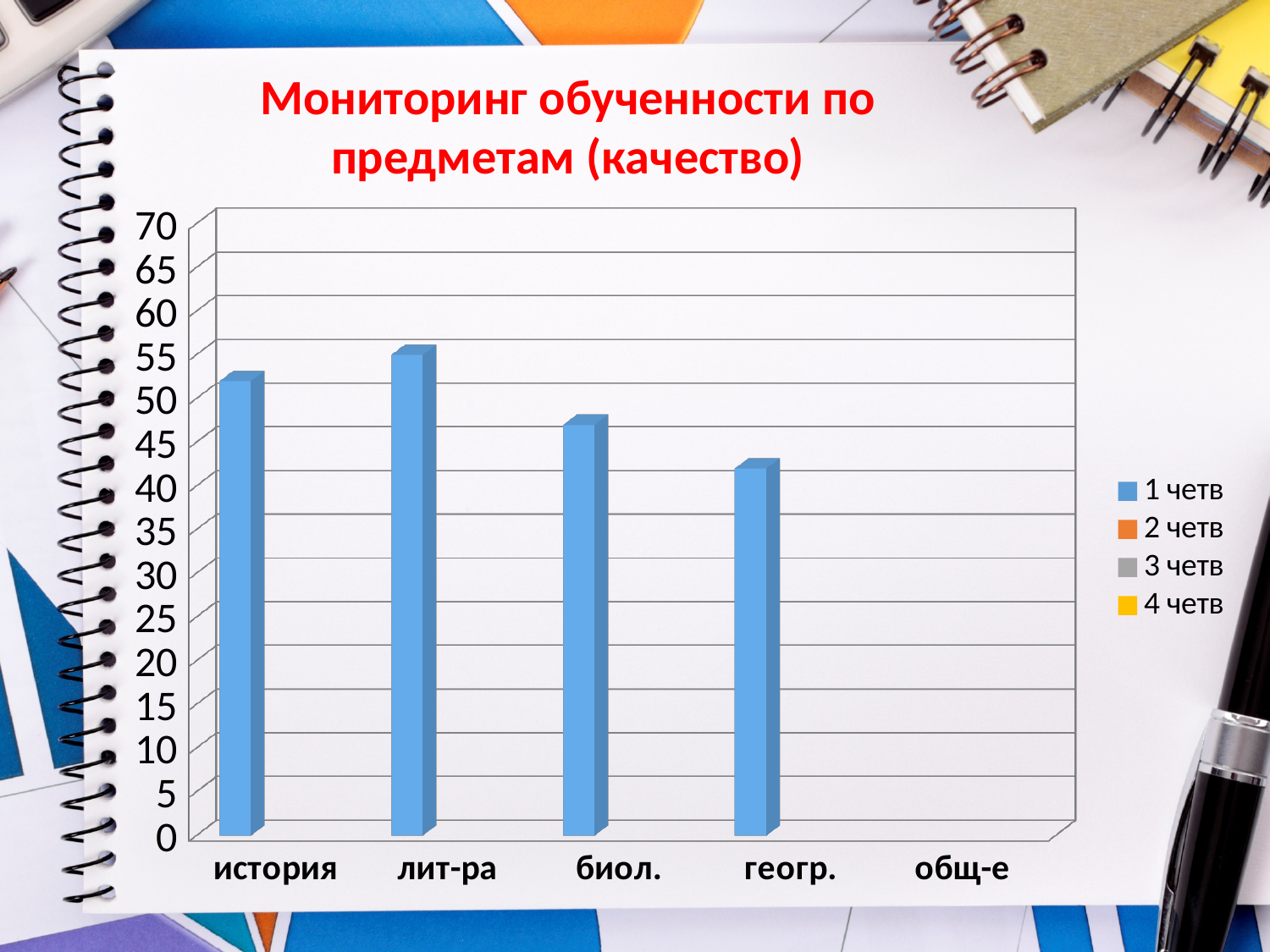
Is the value for лит-ра greater or less than 50? greater Is the value for геогр. greater or less than 45? less Among the categories that have a bar, which one has the lowest value? геогр. Which is larger, the value for история or the value for лит-ра? лит-ра Which is larger, the value for биол. or the value for геогр.? биол. Which category has the highest bar? лит-ра What is the title of the chart? Мониторинг обученности по предметам (качество) How many categories are shown on the x axis? 5 How many series does the legend list? 4 Do the values rise or fall along the x axis from лит-ра to геогр.? fall What kind of chart is shown on the slide? bar chart Is the value for биол. greater or less than 50? less